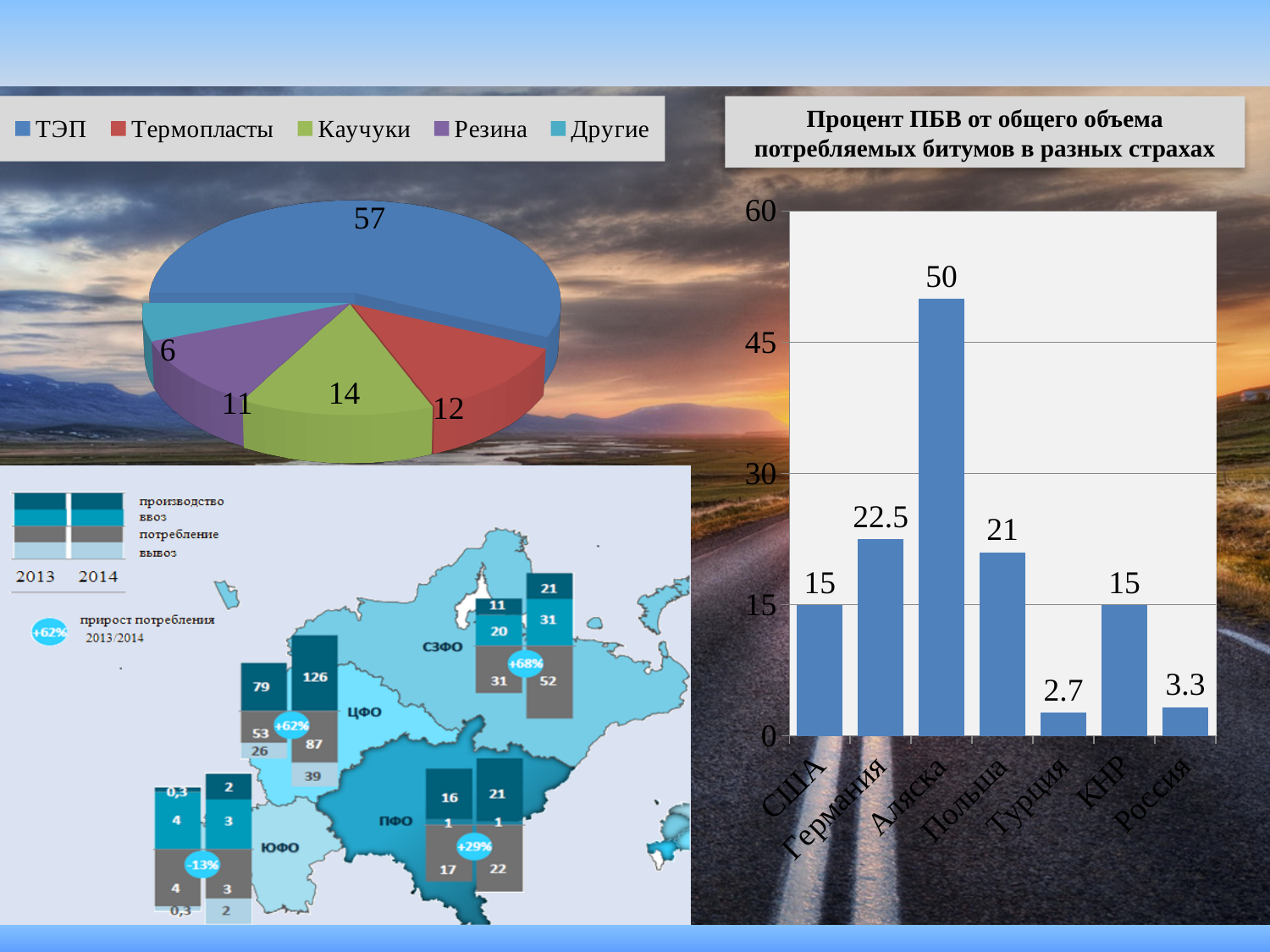
In the pie chart at the top left, what is the difference between the values for Каучуки and Термопласты? 2 How many entries does the legend of the pie chart at the top left list? 5 In the bar chart titled "Процент ПБВ от общего объема потребляемых битумов в разных страхах", what is the value for Аляска? 50 In the bar chart on the right, how many countries are shown on the x axis? 7 In the bar chart on the right, what is the value for Германия? 22.5 In the bar chart on the right, which is larger, the value for Германия or the value for Польша? Германия In the bar chart on the right, what is the difference between the values for Аляска and Польша? 29 In the pie chart at the top left, what is the value for ТЭП? 57 In the pie chart at the top left, which category has the smallest slice? Другие What kind of chart is the chart on the right of the slide? bar chart In the bar chart on the right, which country has the lowest value? Турция In the bar chart on the right, which country has the highest value? Аляска